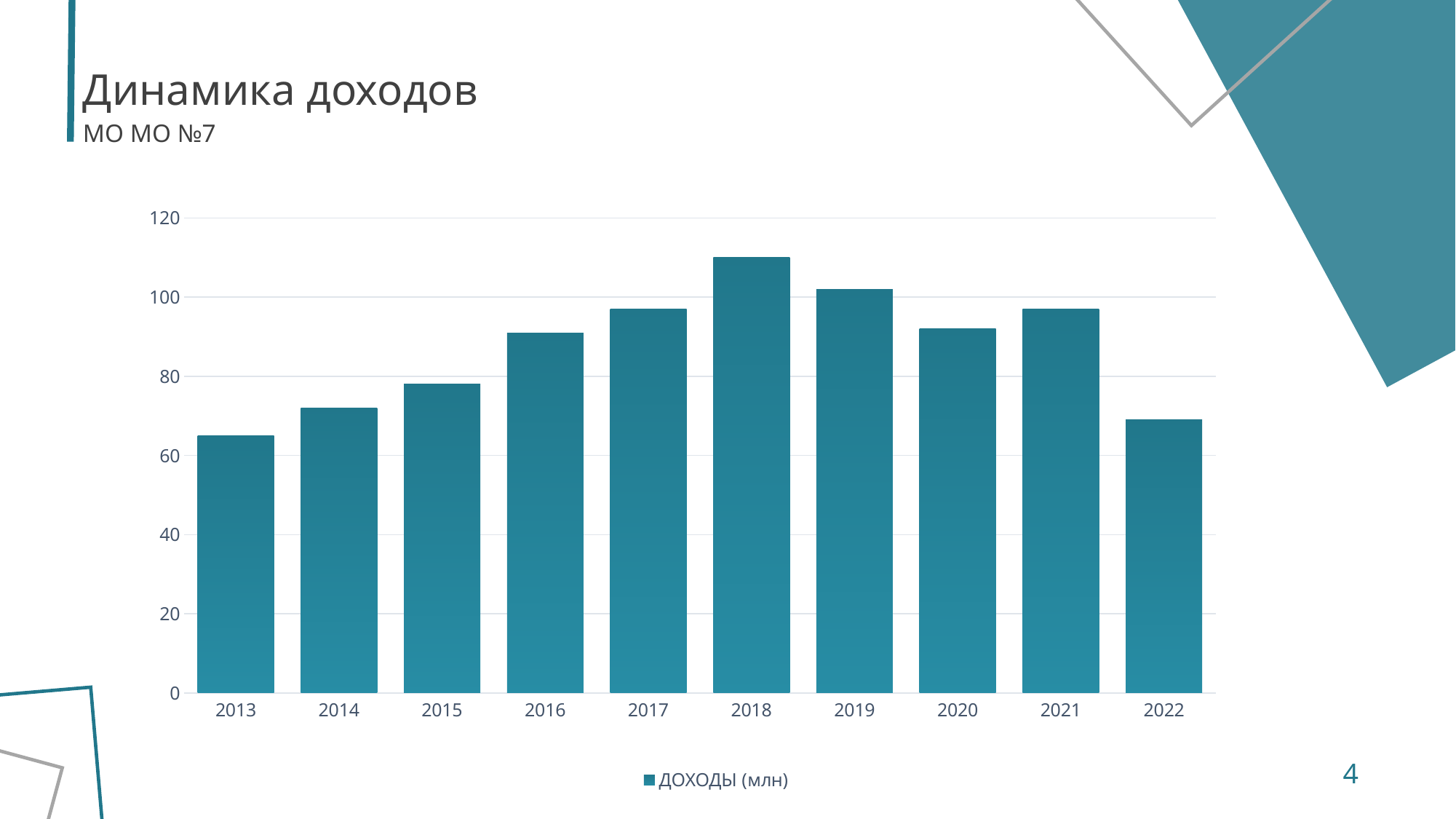
What is the series name shown in the legend? ДОХОДЫ (млн) How many years are shown on the x axis of the chart? 10 Is the value for 2018 greater or less than 100? greater What kind of chart is shown on the slide? bar chart Is the value for 2013 greater or less than 80? less Which year has the lowest value for ДОХОДЫ (млн)? 2013 How many series does the legend list? 1 Do the values rise or fall from 2013 to 2018? rise Which year has the highest value for ДОХОДЫ (млн)? 2018 Is the value for 2016 greater or less than 100? less Which is larger, the value for 2018 or the value for 2019? 2018